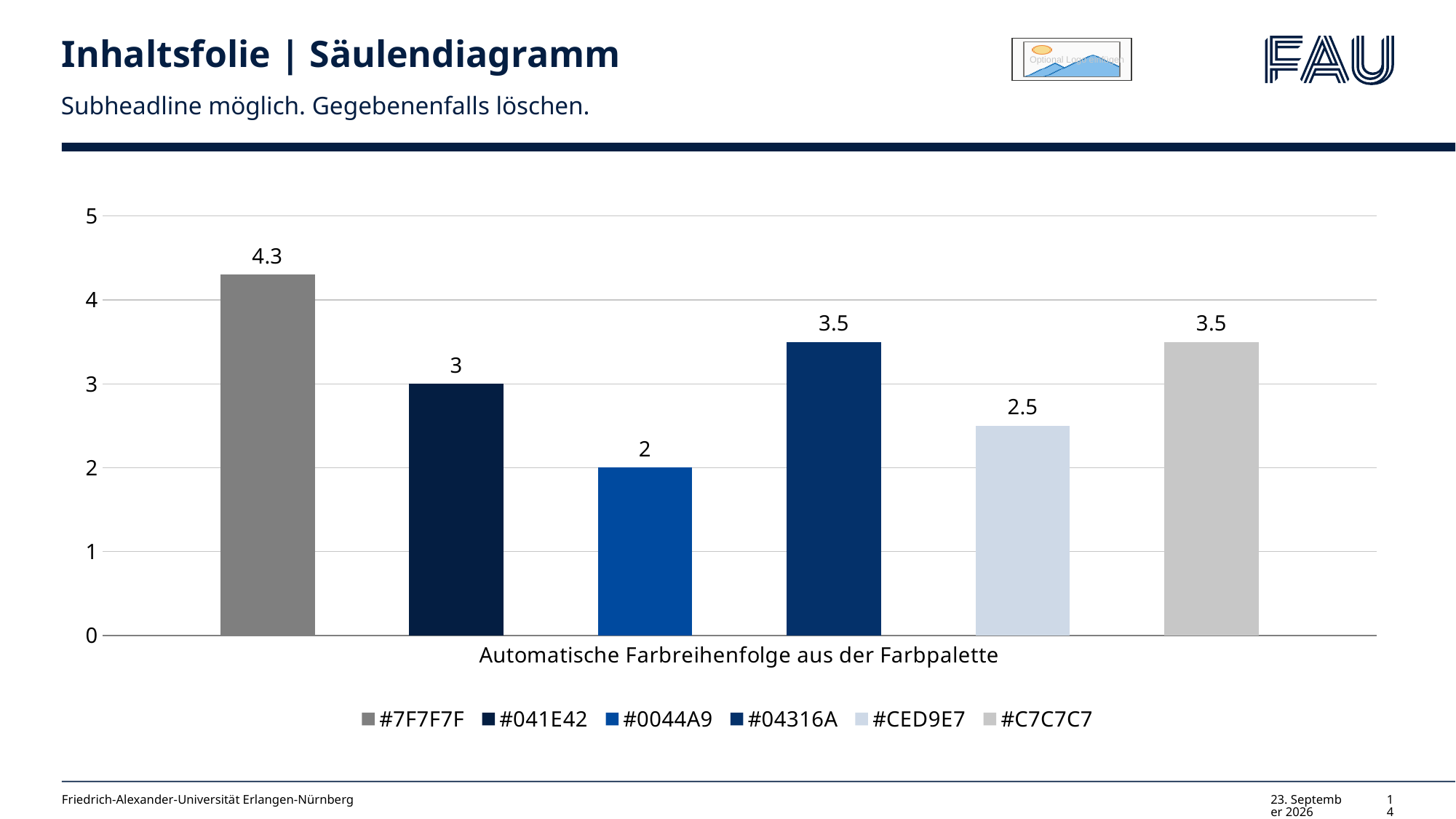
Which is larger, the #04316A bar or the #CED9E7 bar? #04316A What is the value of the #7F7F7F bar? 4.3 What value is shown for the #0044A9 series? 2 Which series has the lowest value? #0044A9 What is the difference between the #7F7F7F bar and the #0044A9 bar? 2.3 Which series has the highest value? #7F7F7F What is the value of the #CED9E7 bar? 2.5 What type of chart is shown on the slide? Bar chart How many series does the legend list? 6 What value does the #041E42 bar show? 3 What is the category label shown on the x axis? Automatische Farbreihenfolge aus der Farbpalette How many bars are plotted in the chart? 6